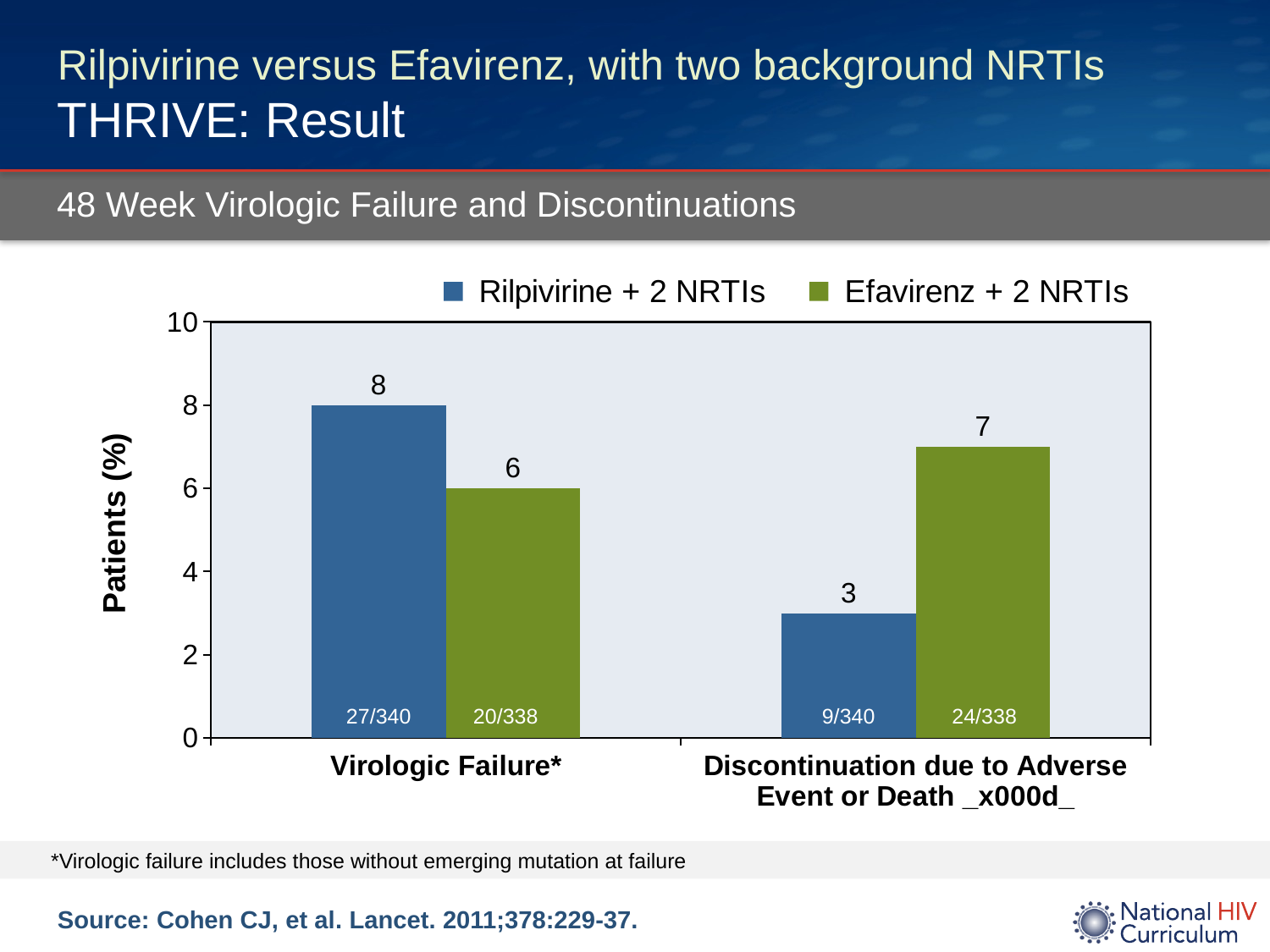
What is the value for Rilpivirine + 2 NRTIs in the Discontinuation due to Adverse Event or Death category? 3 How many categories are shown on the x axis? 2 What is the label of the y axis? Patients (%) Which series has the higher value in the Discontinuation due to Adverse Event or Death category? Efavirenz + 2 NRTIs What is the difference between the Efavirenz + 2 NRTIs and Rilpivirine + 2 NRTIs values in the Discontinuation due to Adverse Event or Death category? 4 What is the difference between the Rilpivirine + 2 NRTIs and Efavirenz + 2 NRTIs values in the Virologic Failure* category? 2 What kind of chart is shown on the slide? Bar chart How many series does the legend list? 2 What is the value for Efavirenz + 2 NRTIs in the Virologic Failure* category? 6 What is the value for Efavirenz + 2 NRTIs in the Discontinuation due to Adverse Event or Death category? 7 What is the value for Rilpivirine + 2 NRTIs in the Virologic Failure* category? 8 Which series has the higher value in the Virologic Failure* category? Rilpivirine + 2 NRTIs